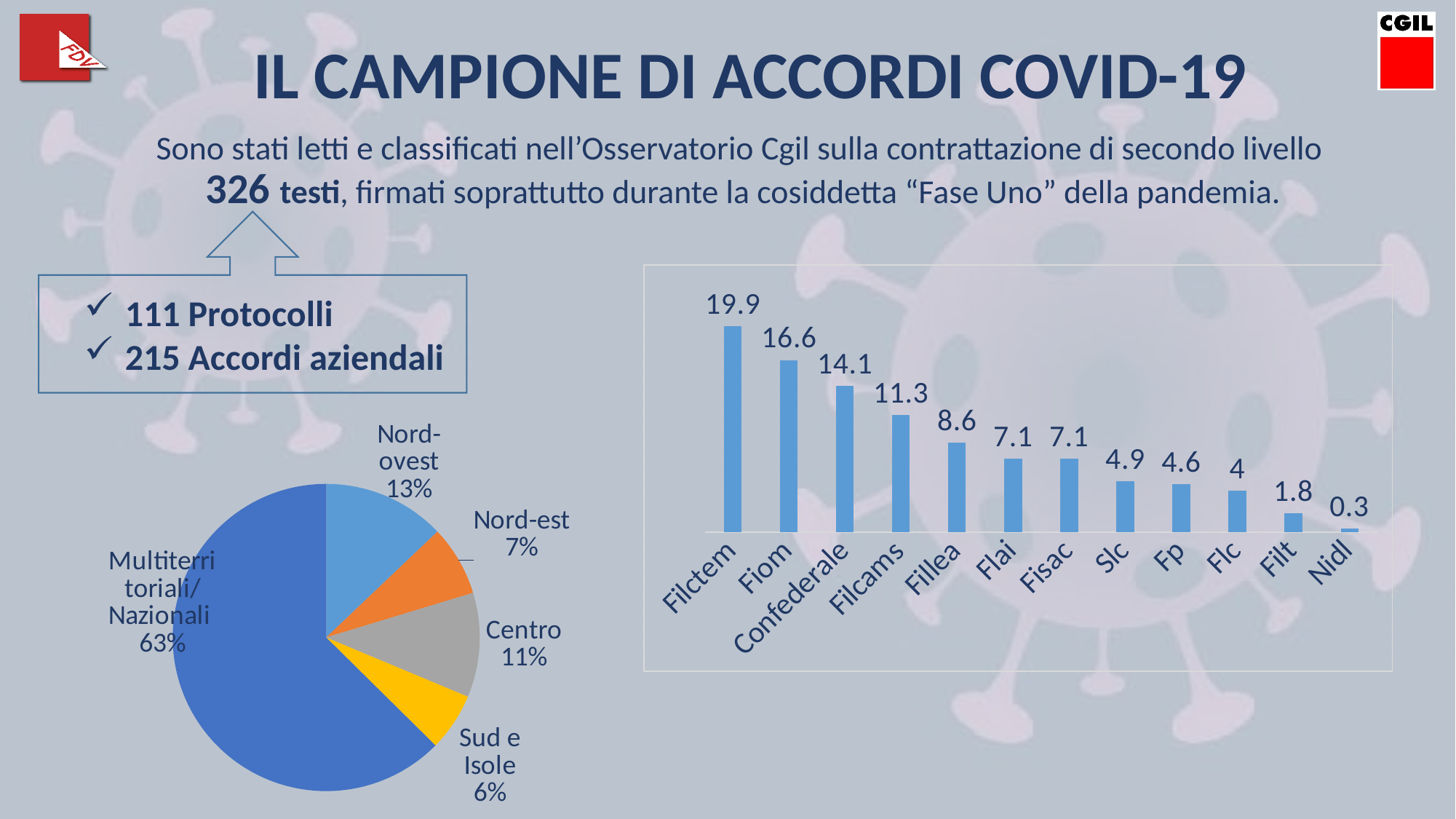
In the bar chart on the right, what is the value for Confederale? 14.1 In the bar chart on the right, which category has the lowest value? Nidl In the bar chart on the right, do the values rise or fall from left to right? fall In the bar chart on the right, how many categories are shown? 12 What kind of chart is on the left of the slide? pie chart In the bar chart on the right, what is the difference between the values for Fiom and Filcams? 5.3 In the pie chart on the left, how many slices are there? 5 In the pie chart on the left, which slice is the largest? Multiterritoriali/Nazionali In the pie chart on the left, what share does Centro have? 11% In the bar chart on the right, which is larger, the value for Slc or the value for Flc? Slc In the bar chart on the right, what is the value for Filctem? 19.9 In the bar chart on the right, which category has the highest value? Filctem